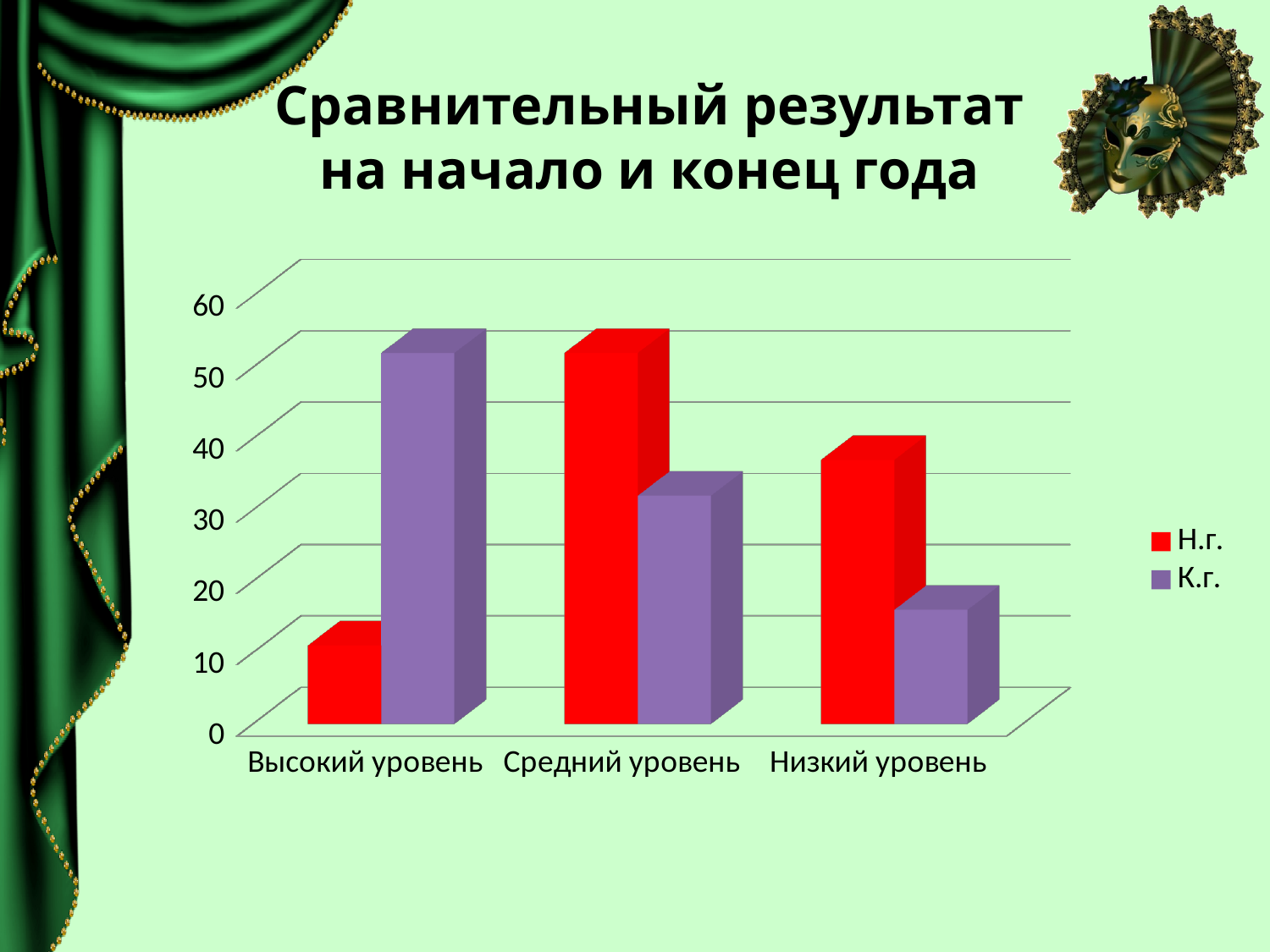
Which category has the lowest value for the Н.г. series? Высокий уровень Is the К.г. value for Низкий уровень greater or less than 30? less How many categories are shown along the x axis of the chart? 3 Which category has the lowest value for the К.г. series? Низкий уровень Which category has the highest value for the Н.г. series? Средний уровень For Высокий уровень, which series has the larger value, Н.г. or К.г.? К.г. For Средний уровень, which series has the larger value, Н.г. or К.г.? Н.г. How many series does the chart legend list? 2 What colour are the bars for the Н.г. series? red Is the Н.г. value for Высокий уровень greater or less than 20? less What kind of chart is shown on the slide? bar chart Which category has the highest value for the К.г. series? Высокий уровень